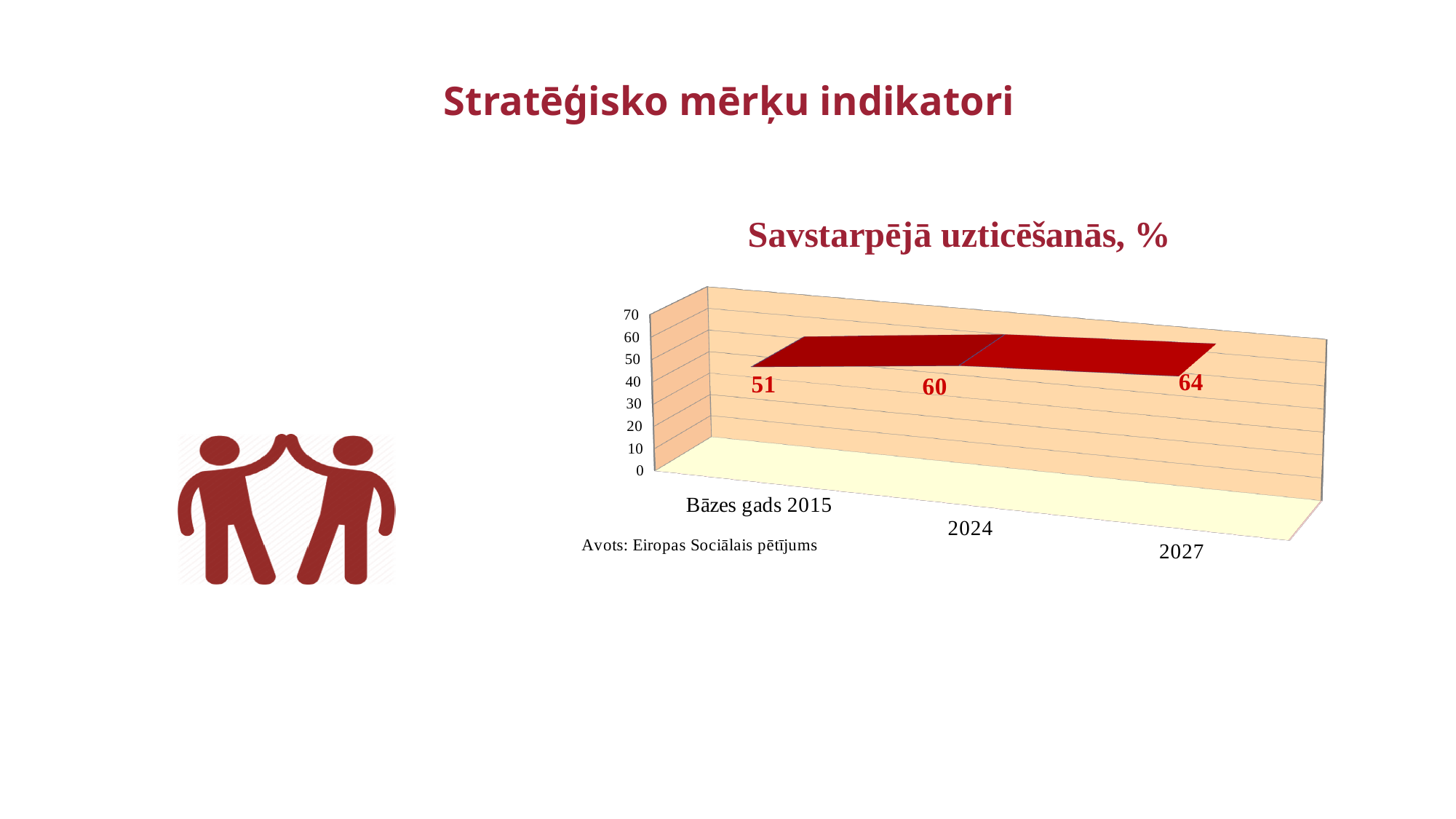
What is the difference between the values for 2027 and Bāzes gads 2015? 13 What is the value for Bāzes gads 2015? 51 What is the highest tick value shown on the vertical axis? 70 How many categories are shown on the x axis? 3 What is the difference between the values for 2024 and Bāzes gads 2015? 9 Which category has the highest value? 2027 What is the value for 2027? 64 Which is larger, the value for 2024 or the value for 2027? 2027 Do the values rise or fall from Bāzes gads 2015 to 2027? rise What is the value for 2024? 60 Which category has the lowest value? Bāzes gads 2015 What is the title of the chart? Savstarpējā uzticēšanās, %